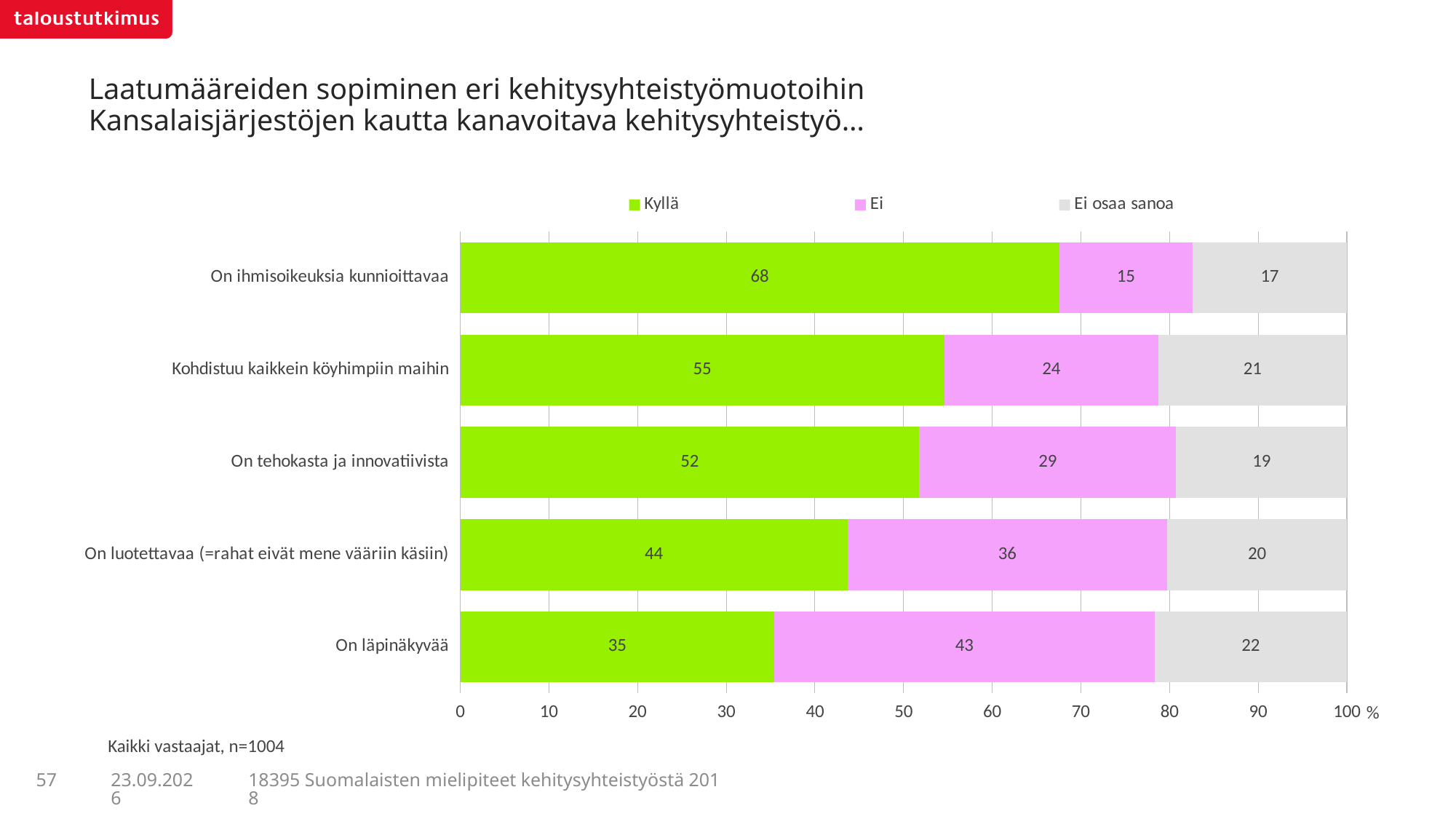
Which category has the lowest "Kyllä" value? On läpinäkyvää What is the "Ei osaa sanoa" value for "On läpinäkyvää"? 22 Which category has the highest "Kyllä" value? On ihmisoikeuksia kunnioittavaa How many series does the legend list? 3 Which legend entry is shown in green? Kyllä Which is larger: the "Ei" value for "On tehokasta ja innovatiivista" or the "Ei" value for "Kohdistuu kaikkein köyhimpiin maihin"? On tehokasta ja innovatiivista What is the difference between the "Kyllä" values for "Kohdistuu kaikkein köyhimpiin maihin" and "On tehokasta ja innovatiivista"? 3 Which category has the highest "Ei" value? On läpinäkyvää What is the "Kyllä" value for "On ihmisoikeuksia kunnioittavaa"? 68 What kind of chart is shown on the slide? Stacked bar chart What is the "Ei" value for "On luotettavaa (=rahat eivät mene vääriin käsiin)"? 36 How many categories are shown on the chart? 5